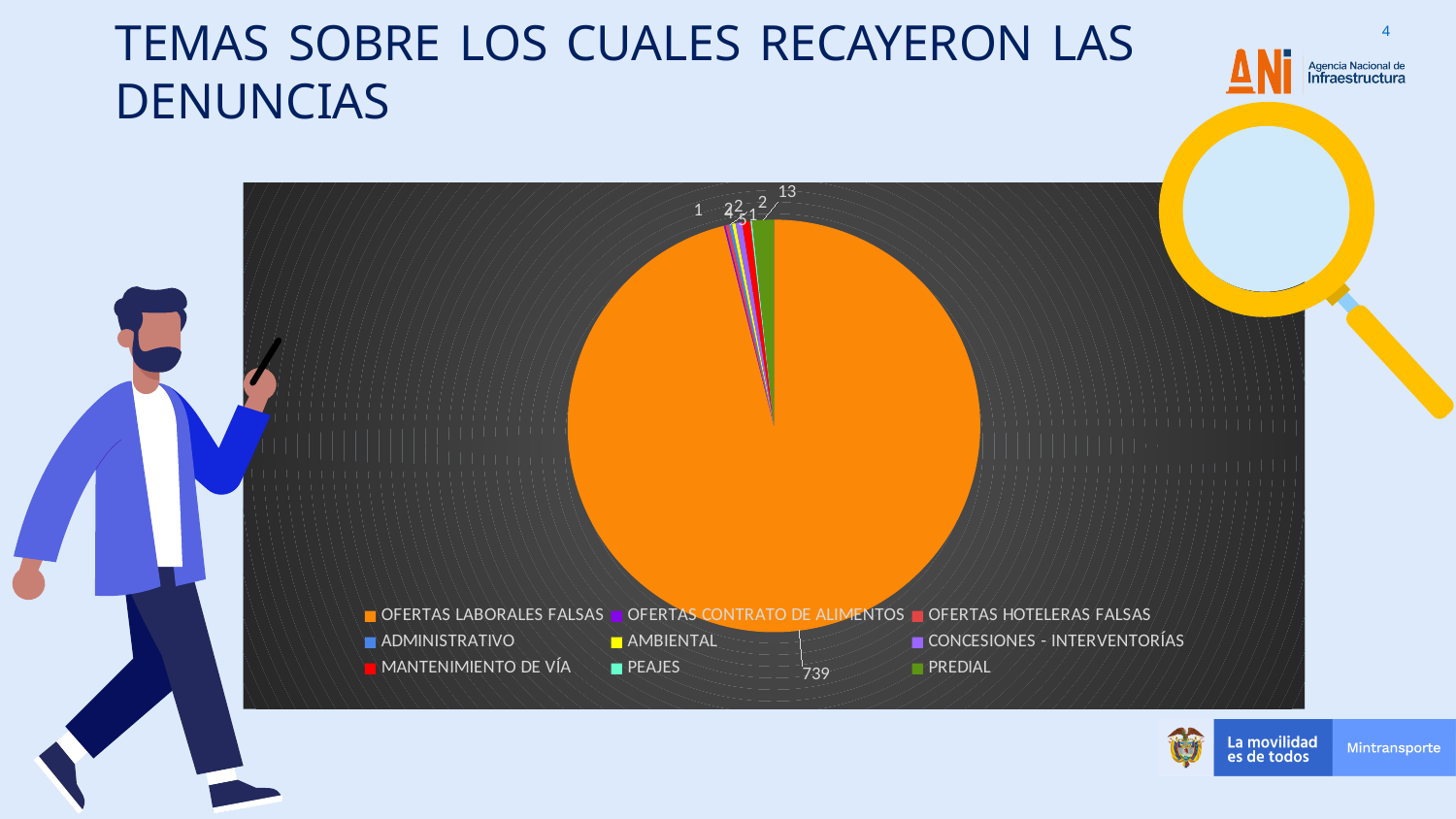
What is the difference between the value for OFERTAS LABORALES FALSAS and the value for PREDIAL? 726 What kind of chart is shown on the slide? Pie chart What is the value for PREDIAL in the pie chart? 13 What is the value for OFERTAS LABORALES FALSAS in the pie chart? 739 What colour is the slice for OFERTAS LABORALES FALSAS in the pie chart? Orange What is the title of the slide containing the pie chart? TEMAS SOBRE LOS CUALES RECAYERON LAS DENUNCIAS Which is larger, the value for OFERTAS LABORALES FALSAS or the value for PREDIAL? OFERTAS LABORALES FALSAS Which category has the largest slice in the pie chart? OFERTAS LABORALES FALSAS How many categories does the legend of the pie chart list? 9